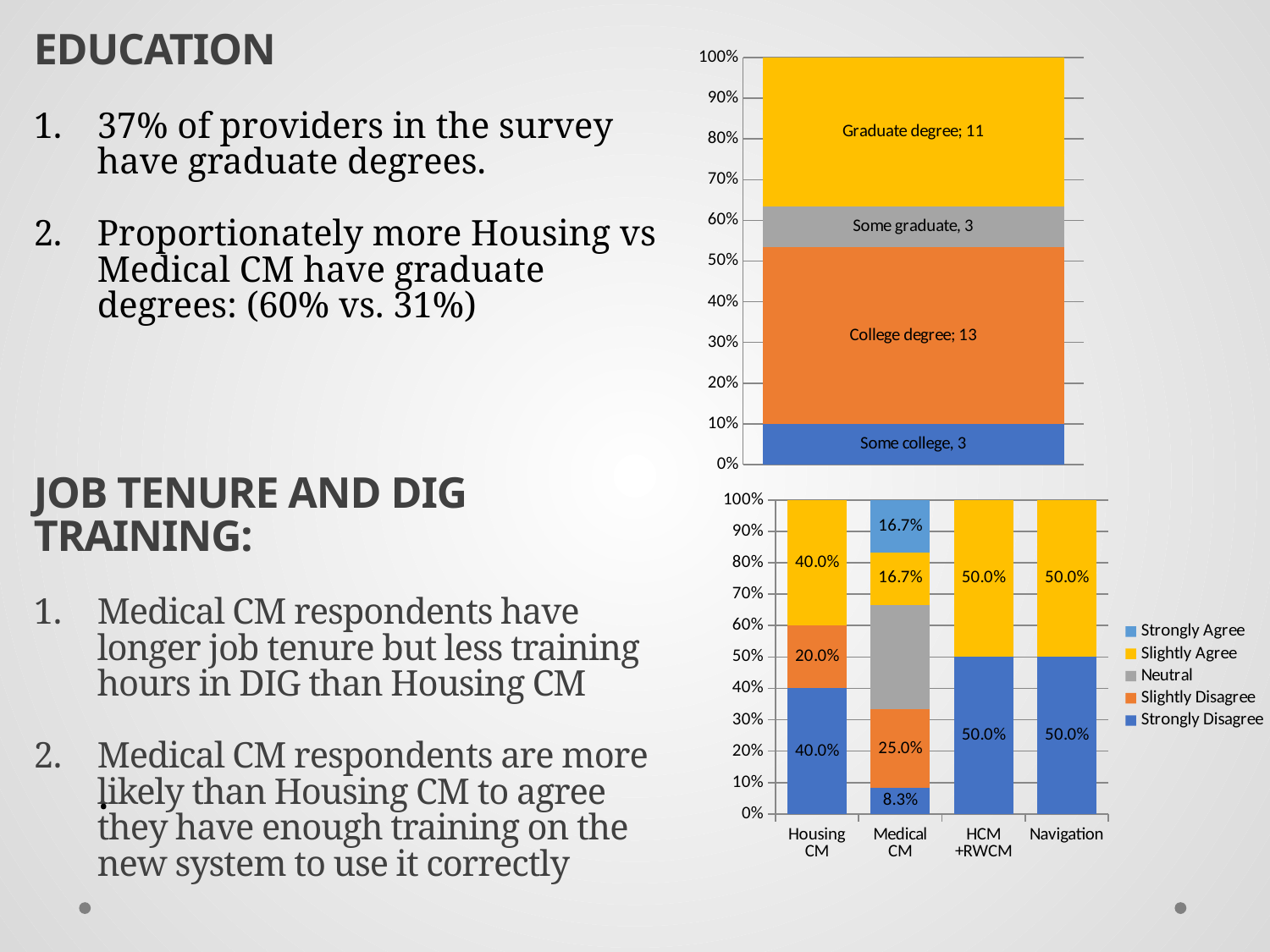
What kind of chart is the top chart? Stacked bar chart In the top chart, how many providers have a college degree? 13 In the top chart, which education category has the largest count? College degree In the top chart, what is the total number of providers across all four education segments? 30 In the bottom chart, what is the difference between the Strongly Disagree and Slightly Disagree values for Housing CM? 20.0% In the bottom chart, how many series does the legend list? 5 In the bottom chart, which is larger: the Slightly Disagree value for Housing CM or for Medical CM? Medical CM In the bottom chart, what is the Strongly Disagree value for Housing CM? 40.0% In the bottom chart, what is the Strongly Disagree value for Medical CM? 8.3% In the bottom chart, how many categories are shown on the x axis? 4 In the top chart, how many providers have a graduate degree? 11 In the top chart, how many education segments make up the stacked bar? 4